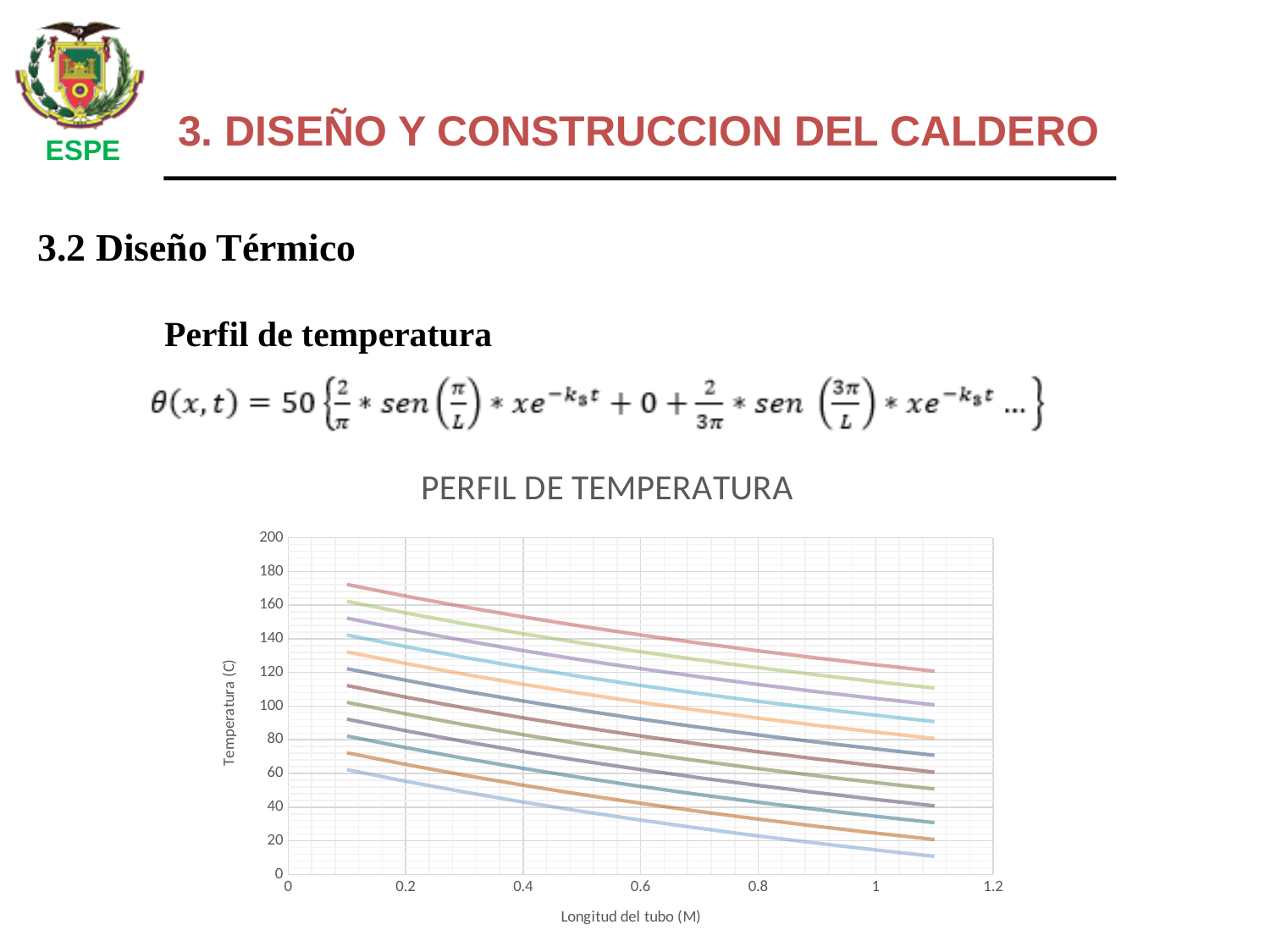
Do the temperature lines in the chart rise or fall as the tube length increases along the x axis? fall Is the starting value of the lowest line in the chart greater or less than 80? less How many lines are plotted in the PERFIL DE TEMPERATURA chart? 12 What is the maximum value shown on the y axis of the chart? 200 Is the starting value of the topmost line in the chart greater or less than 160? greater Is the starting value of the lowest line in the chart greater or less than 40? greater What is the title of the chart on the slide? PERFIL DE TEMPERATURA What kind of chart is shown under the title PERFIL DE TEMPERATURA? line chart What is the label of the x axis of the chart? Longitud del tubo (M)